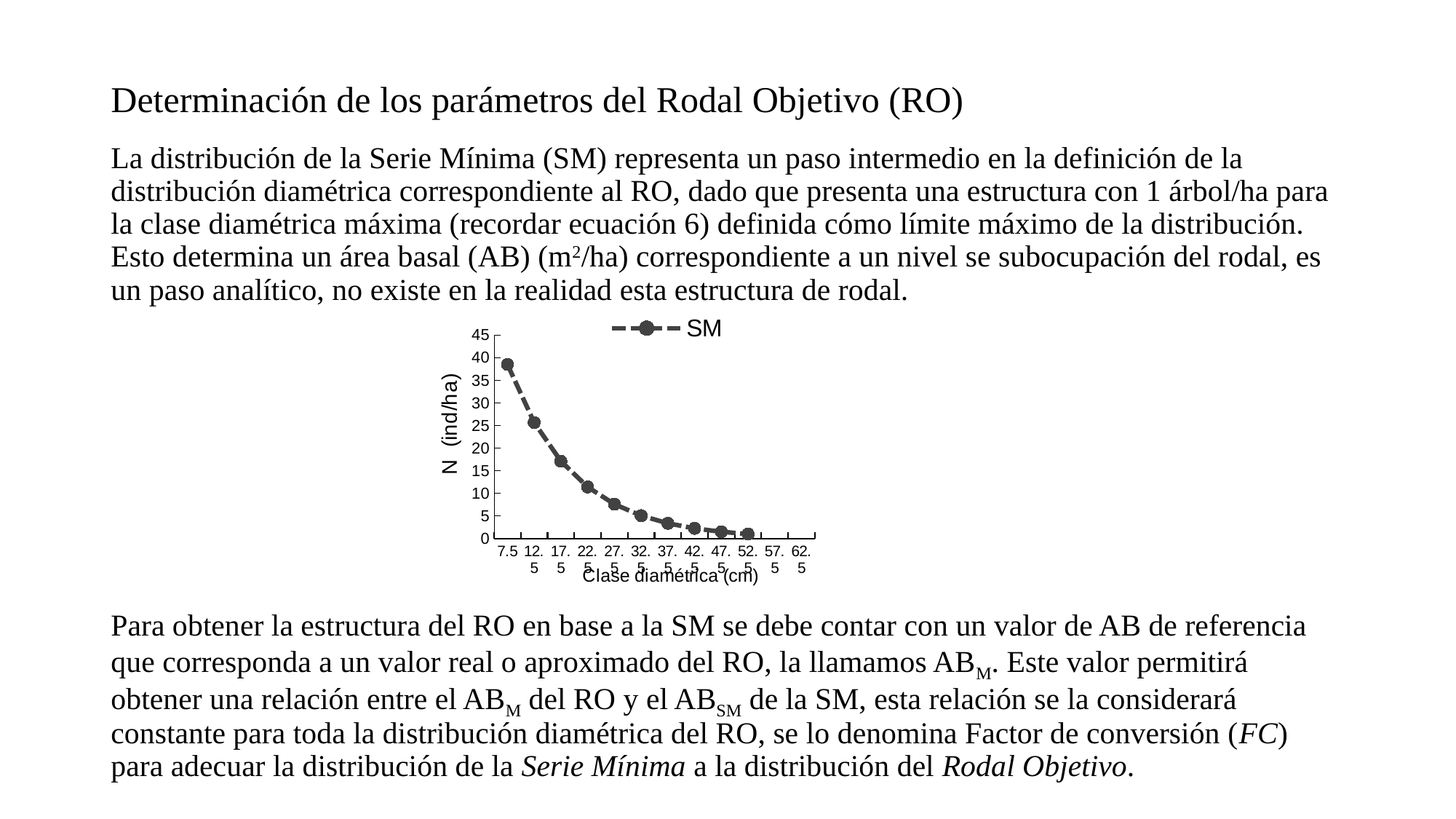
What is the name of the series shown in the legend? SM Which diameter class has the lowest plotted value of N? 52.5 Which has a larger value of N, diameter class 17.5 or diameter class 37.5? 17.5 How many series does the legend list? 1 Is the value for diameter class 7.5 greater or less than 35? greater Is the value for diameter class 27.5 greater or less than 10? less What kind of chart is shown on the slide? line chart Do the values rise or fall as the diameter class increases along the x axis? fall Which diameter class has the highest value of N? 7.5 What is the title of the y axis? N (ind/ha) Is the value for diameter class 22.5 greater or less than 15? less